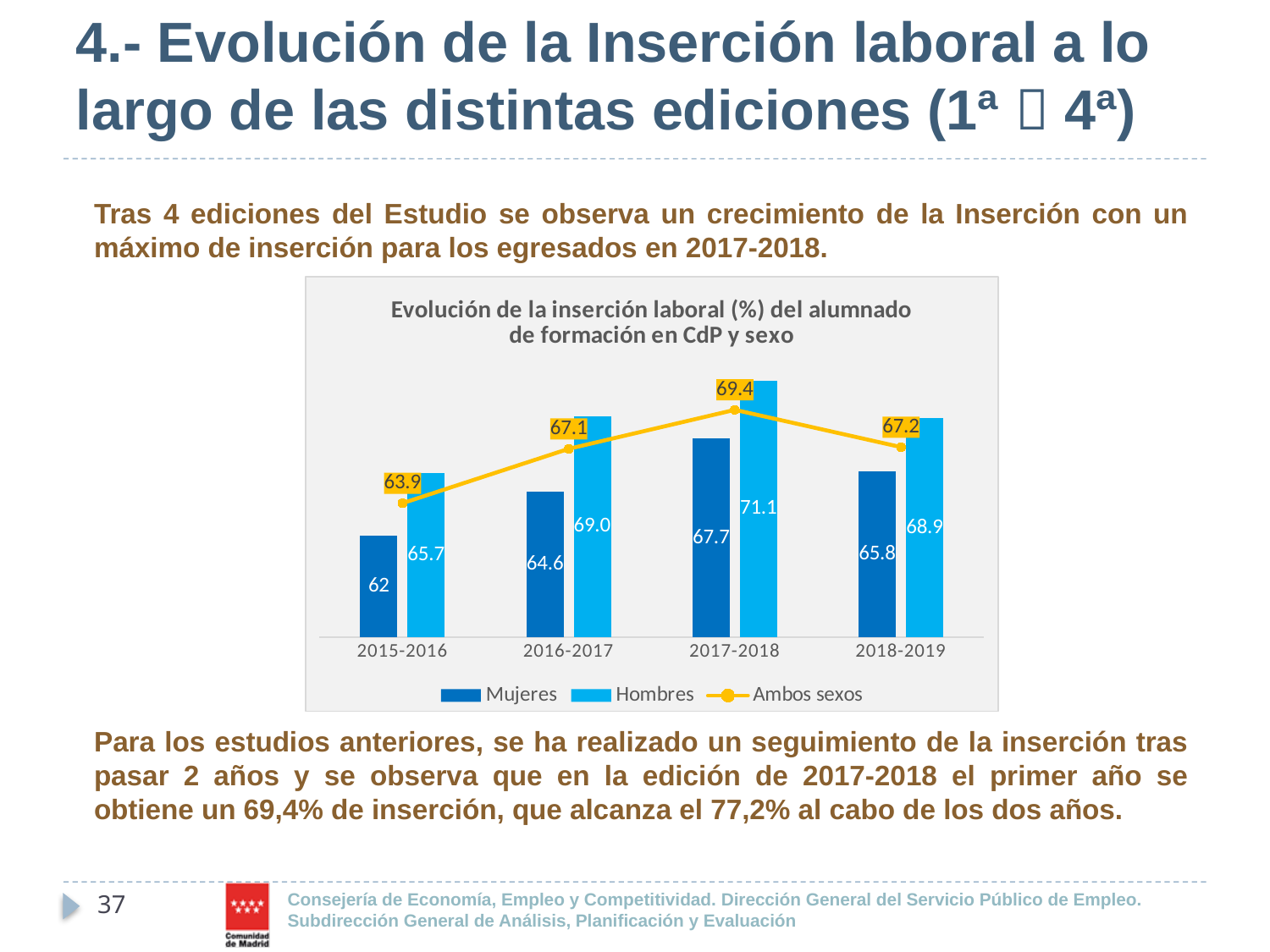
How many editions (categories) are shown on the x axis? 4 In which edition is the Mujeres value lowest? 2015-2016 What is the value for Mujeres in 2015-2016? 62 How many series does the legend list? 3 What is the value for Hombres in 2018-2019? 68.9 What is the value for Hombres in 2017-2018? 71.1 What is the value for Ambos sexos in 2016-2017? 67.1 Which is larger in 2018-2019, the Mujeres value or the Hombres value? Hombres What is the difference between the Hombres and Mujeres values in 2016-2017? 4.4 What is the title of the chart? Evolución de la inserción laboral (%) del alumnado de formación en CdP y sexo What kind of chart is used for the Mujeres and Hombres series? Bar chart In which edition is the Ambos sexos value highest? 2017-2018